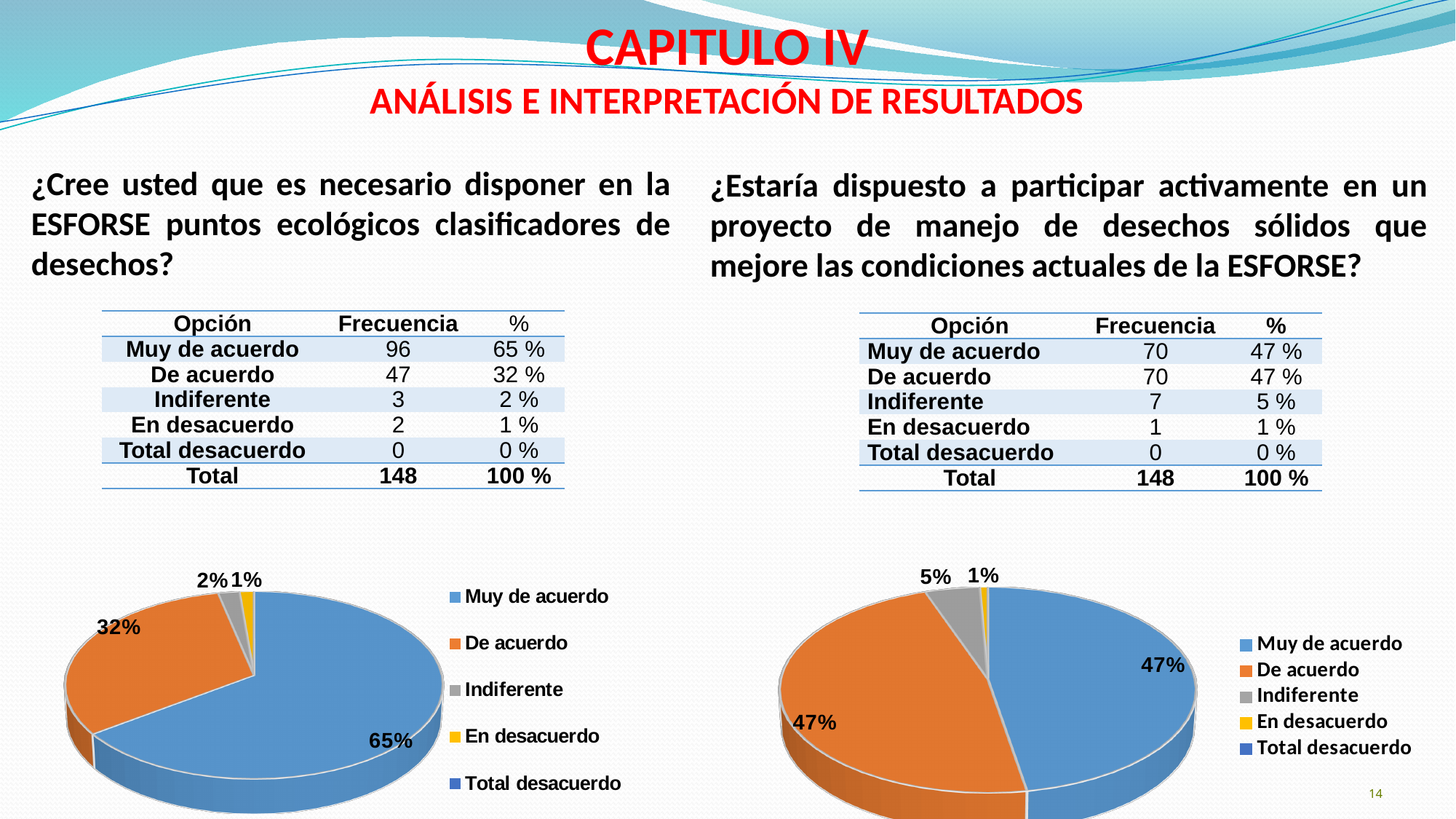
In the right pie chart, what colour is the De acuerdo slice? Orange How many entries does the legend of the left pie chart list? 5 In the right pie chart, what share is labelled for Muy de acuerdo? 47% In the right pie chart, what share is labelled for En desacuerdo? 1% In the left pie chart, which category has the largest slice? Muy de acuerdo What kind of chart is shown on the left side of the slide? Pie chart In the right pie chart, which is larger, the Indiferente slice or the En desacuerdo slice? Indiferente In the right pie chart, what share is labelled for Indiferente? 5% In the left pie chart, what is the difference between the Muy de acuerdo and De acuerdo shares? 33%